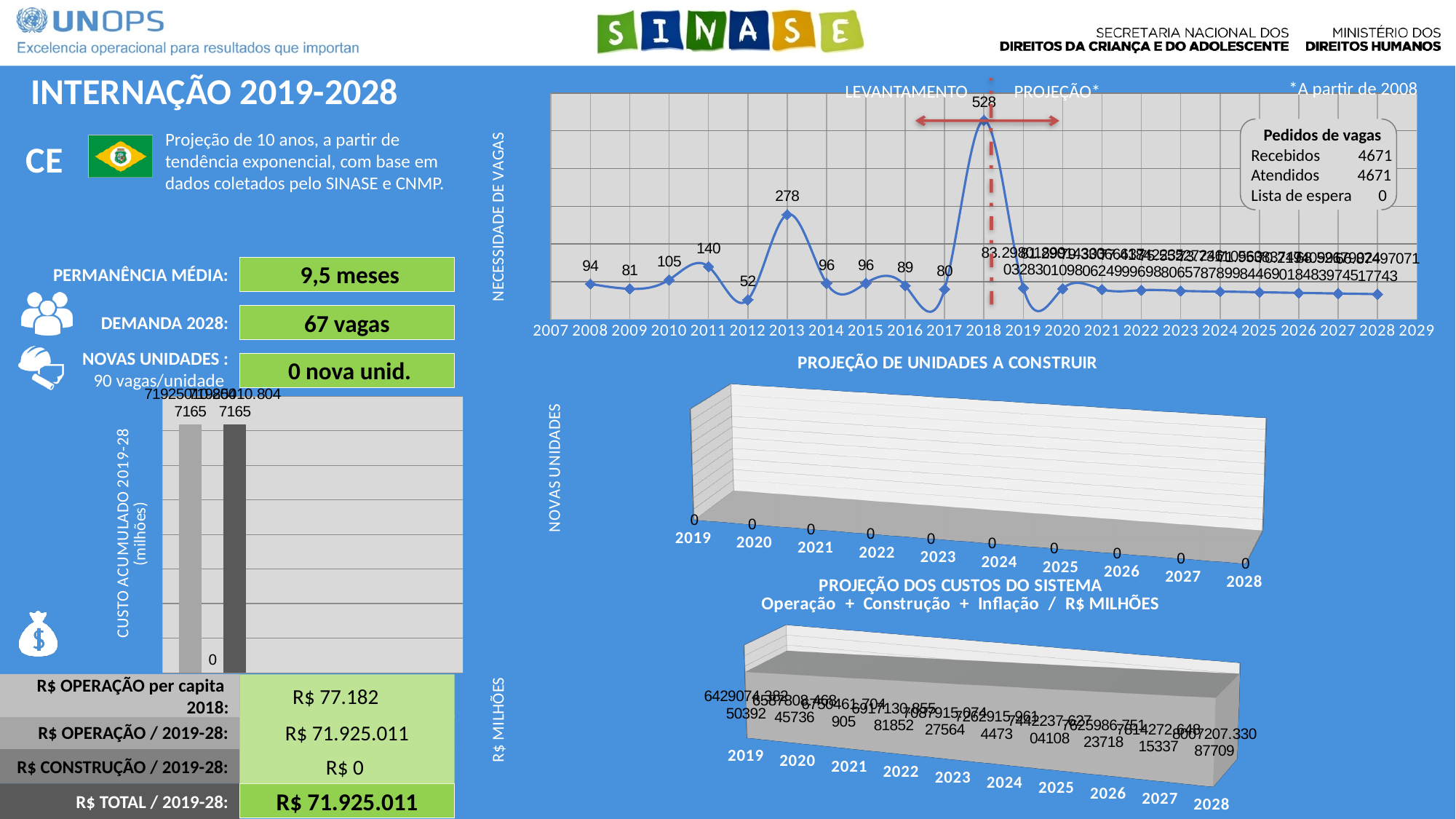
In the line chart of NECESSIDADE DE VAGAS, what is the value for 2018? 528 What kind of chart is the NECESSIDADE DE VAGAS chart at the top right? line chart In the chart PROJEÇÃO DE UNIDADES A CONSTRUIR, what is the value for 2024? 0 In the line chart of NECESSIDADE DE VAGAS, what is the difference between the 2011 value and the 2012 value? 88 In the line chart of NECESSIDADE DE VAGAS, what is the value for 2012? 52 How many years are shown on the x axis of the chart PROJEÇÃO DE UNIDADES A CONSTRUIR? 10 In the line chart of NECESSIDADE DE VAGAS, what is the value for 2013? 278 In the line chart of NECESSIDADE DE VAGAS, which is larger, the value for 2010 or the value for 2009? 2010 In the line chart of NECESSIDADE DE VAGAS, what is the value for 2011? 140 In the line chart of NECESSIDADE DE VAGAS, which year has the highest value? 2018 In the line chart of NECESSIDADE DE VAGAS, what is the difference between the 2018 value and the 2013 value? 250